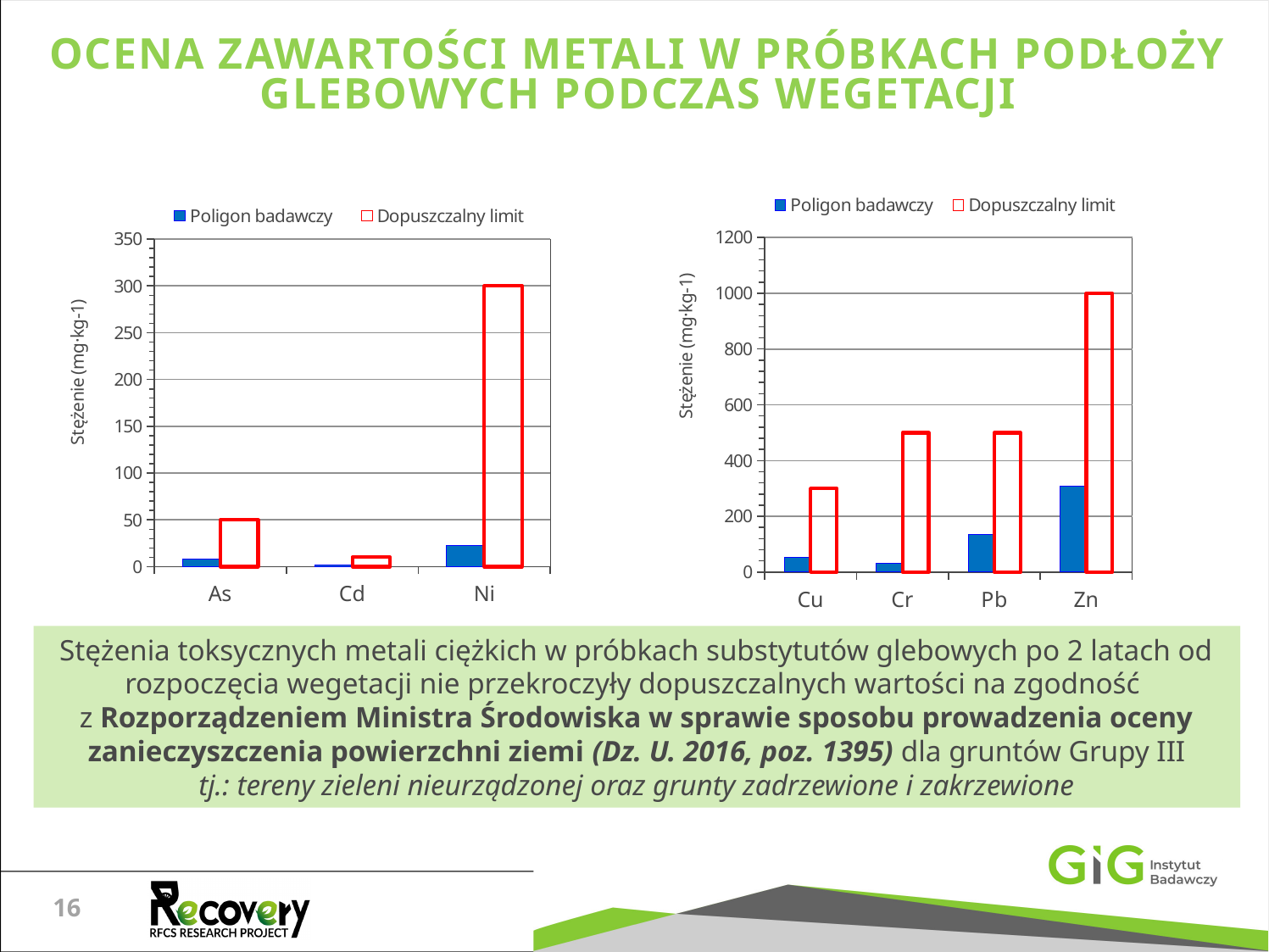
On the right chart (Cu, Cr, Pb, Zn), is the Poligon badawczy value for Pb greater or less than 200? less On the right chart (Cu, Cr, Pb, Zn), which category has the lowest Dopuszczalny limit? Cu On the left chart (As, Cd, Ni), what is the Dopuszczalny limit value for As? 50 On the right chart (Cu, Cr, Pb, Zn), is the Poligon badawczy value for Zn greater or less than 200? greater On the right chart (Cu, Cr, Pb, Zn), which is larger for Pb: the Poligon badawczy value or the Dopuszczalny limit? Dopuszczalny limit On the right chart (Cu, Cr, Pb, Zn), what is the Dopuszczalny limit value for Zn? 1000 On the right chart (Cu, Cr, Pb, Zn), which category has the highest Poligon badawczy value? Zn How many series does the legend of the left chart (As, Cd, Ni) list? 2 On the left chart (As, Cd, Ni), which category has the highest Dopuszczalny limit? Ni How many categories are shown on the right chart (Cu, Cr, Pb, Zn)? 4 On the left chart (As, Cd, Ni), what is the Dopuszczalny limit value for Ni? 300 On the left chart (As, Cd, Ni), is the Poligon badawczy value for Ni greater or less than 50? less